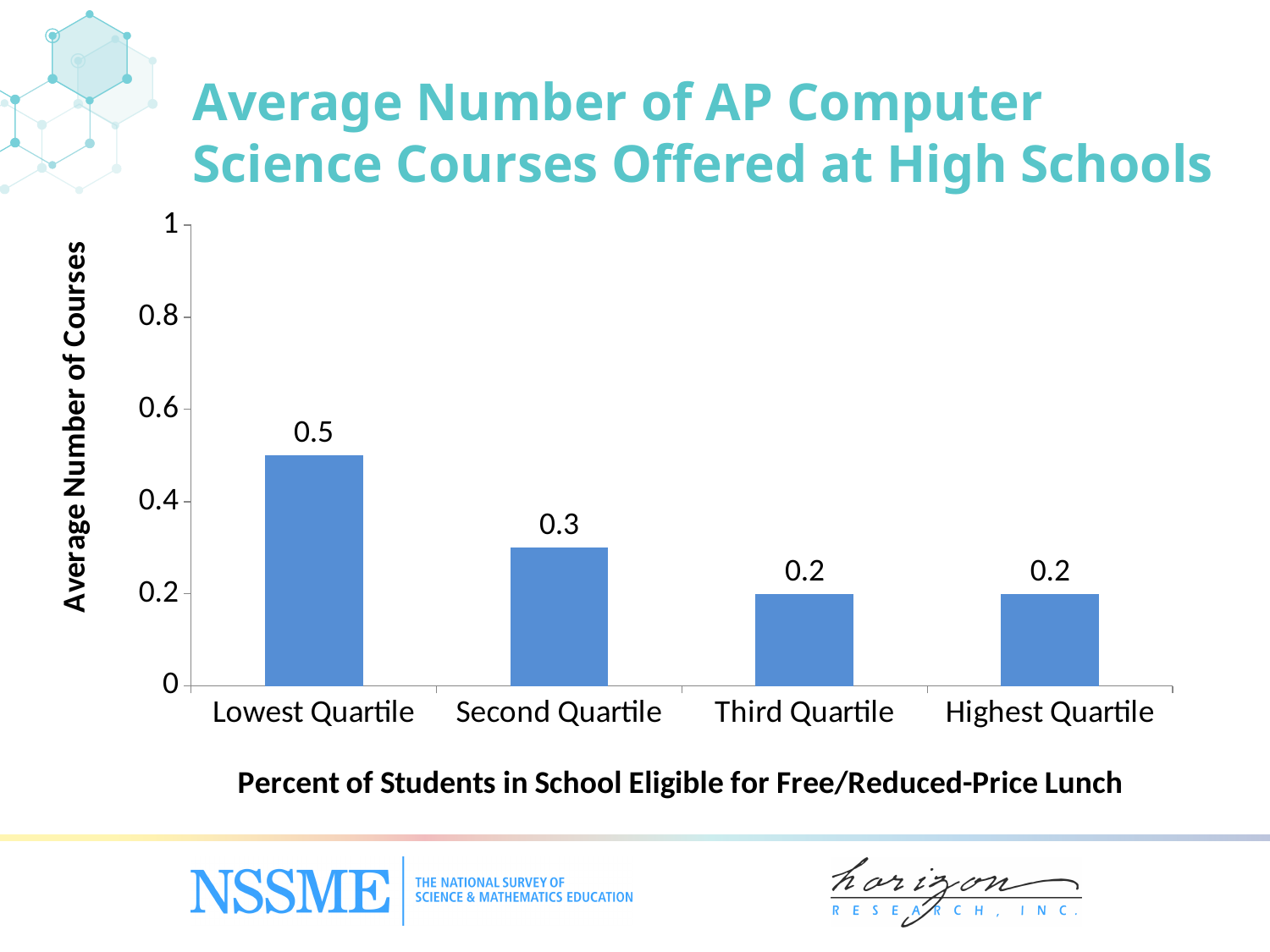
What is the difference between the values for the Lowest Quartile and the Highest Quartile? 0.3 Do the values rise or fall moving from the Lowest Quartile to the Highest Quartile? Fall Which quartile has the highest average number of AP Computer Science courses? Lowest Quartile What is the value for the Third Quartile? 0.2 What is the value for the Second Quartile? 0.3 What kind of chart is shown on the slide? Bar chart Which is larger, the value for the Lowest Quartile or the value for the Second Quartile? Lowest Quartile Is the value for the Lowest Quartile greater or less than 0.4? greater How many quartile categories are shown on the x axis? 4 What is the average number of AP Computer Science courses offered at high schools in the Lowest Quartile? 0.5 What is the value for the Highest Quartile? 0.2 What is the difference between the values for the Lowest Quartile and the Second Quartile? 0.2